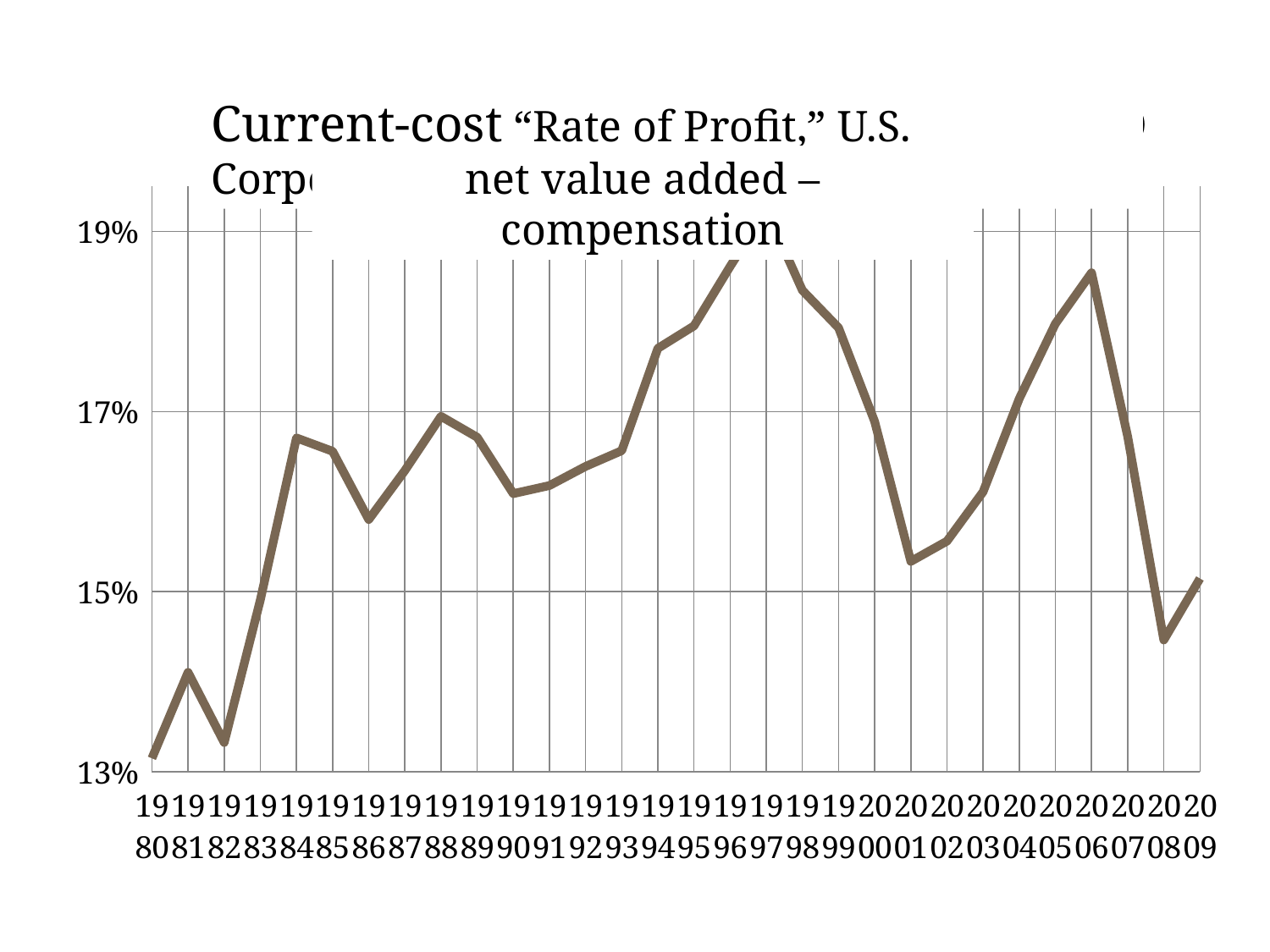
In which year does the rate of profit reach its highest value? 1997 Does the line rise or fall from 2006 to 2008? fall Which year has the larger value, 1981 or 1982? 1981 Is the value for 1996 greater or less than 18%? greater Is the value for 2008 greater or less than 15%? less Is the value for 1986 greater or less than 15%? greater What is the lowest value shown on the y axis? 13% What kind of chart is shown on the slide? line chart How many years are plotted along the x axis? 30 Which year has the larger value, 2006 or 2008? 2006